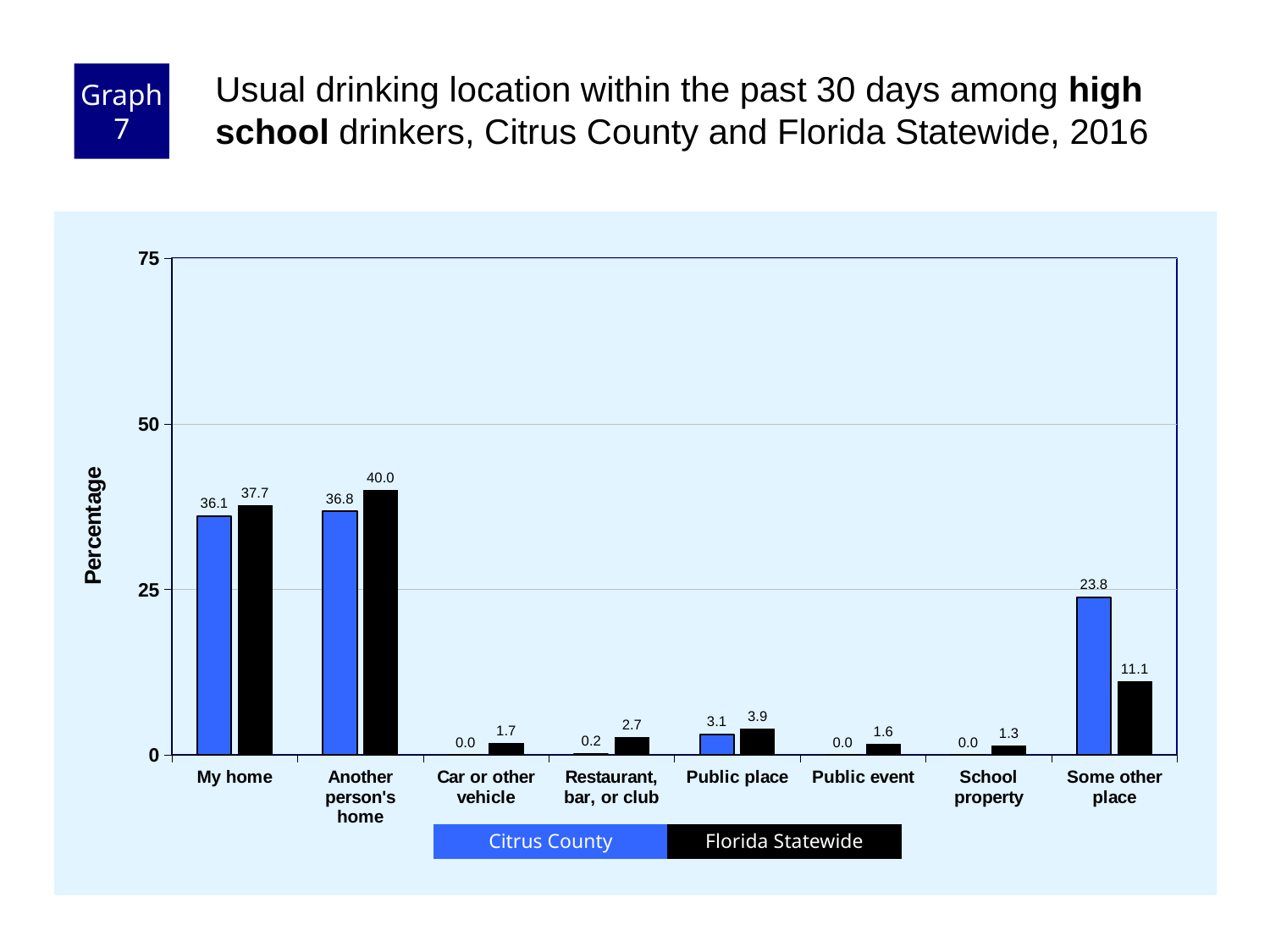
What is the Florida Statewide value for "Another person's home"? 40.0 How many location categories are shown on the x axis? 8 What kind of chart is shown on the slide? Bar chart What is the Citrus County value for "Some other place"? 23.8 What is the Citrus County value for "My home"? 36.1 What is the difference between the Citrus County and Florida Statewide values for "Some other place"? 12.7 Which category has the highest Florida Statewide value? Another person's home How many series does the legend list? 2 Which category has the lowest Florida Statewide value? School property What colour represents Citrus County in the chart? Blue Is the Florida Statewide value for "My home" greater or less than 25? greater Which is larger for "Public place": the Citrus County value or the Florida Statewide value? Florida Statewide